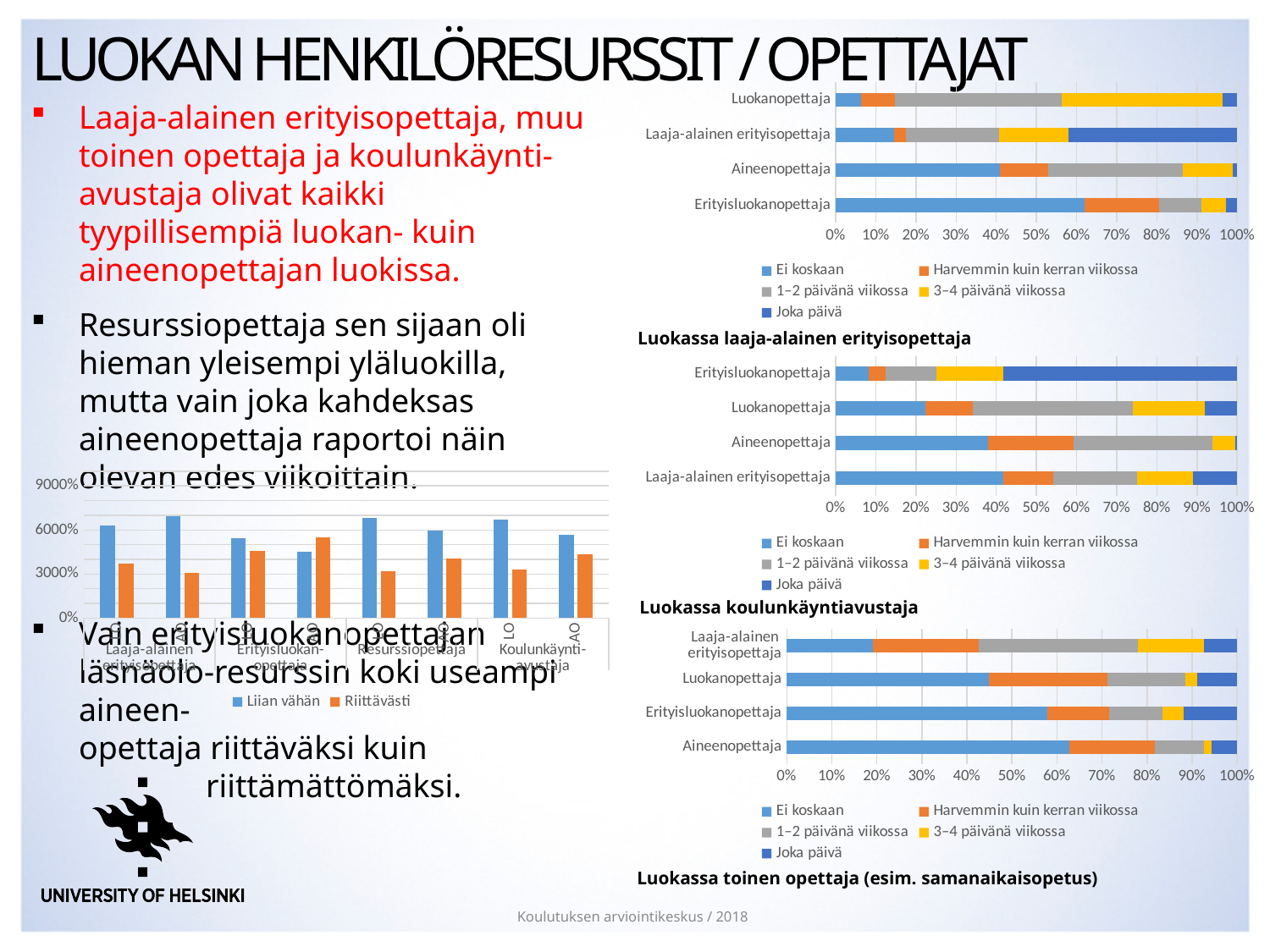
In the chart titled 'Luokassa laaja-alainen erityisopettaja', is the 'Ei koskaan' value for Luokanopettaja greater or less than 10%? less In the chart titled 'Luokassa koulunkäyntiavustaja', is the 'Joka päivä' value for Erityisluokanopettaja greater or less than 50%? greater How many series does the legend list in the bar chart on the left side of the slide? 2 What kind of chart is the chart titled 'Luokassa laaja-alainen erityisopettaja'? Stacked bar chart How many categories are shown in the chart titled 'Luokassa toinen opettaja (esim. samanaikaisopetus)'? 4 In the chart titled 'Luokassa toinen opettaja (esim. samanaikaisopetus)', is the 'Ei koskaan' value for Aineenopettaja greater or less than 50%? greater In the chart titled 'Luokassa koulunkäyntiavustaja', which category has the largest 'Joka päivä' share? Erityisluokanopettaja In the chart titled 'Luokassa toinen opettaja (esim. samanaikaisopetus)', which category has the smallest 'Ei koskaan' share? Laaja-alainen erityisopettaja What are the legend entries of the bar chart on the left side of the slide? Liian vähän, Riittävästi How many series does the legend list in the chart titled 'Luokassa koulunkäyntiavustaja'? 5 In the bar chart on the left side of the slide, which is larger for Laaja-alainen erityisopettaja LO: 'Liian vähän' or 'Riittävästi'? Liian vähän